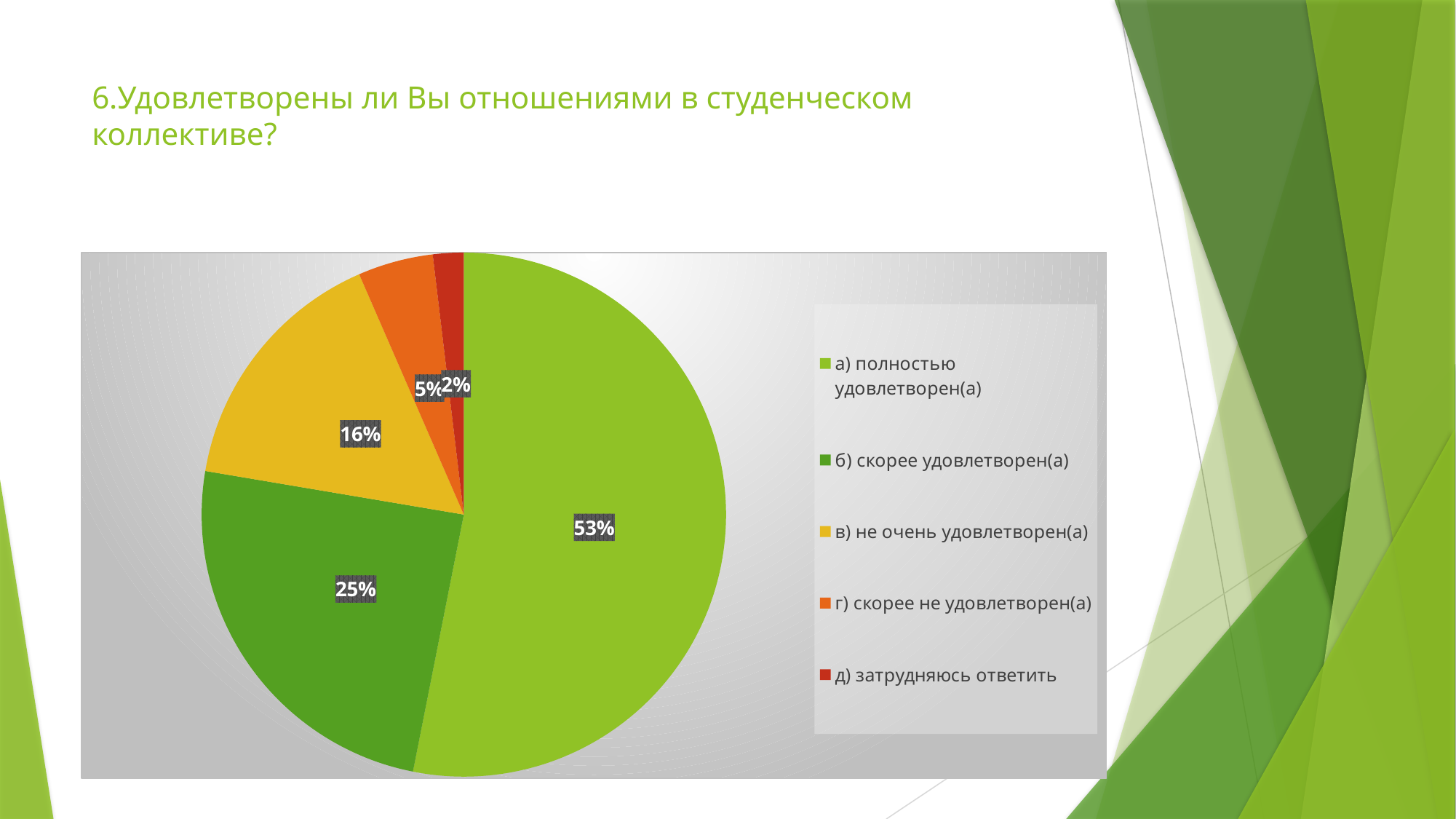
What is the value for "б) скорее удовлетворен(а)"? 25% What is the value for "г) скорее не удовлетворен(а)"? 5% What colour is the slice for "в) не очень удовлетворен(а)"? yellow How many categories does the pie chart have? 5 Which category has the smallest slice of the pie? д) затрудняюсь ответить Which category has the largest slice of the pie? а) полностью удовлетворен(а) Which is larger: the value for "в) не очень удовлетворен(а)" or the value for "г) скорее не удовлетворен(а)"? в) не очень удовлетворен(а) What kind of chart is shown on the slide? pie chart What is the value for "д) затрудняюсь ответить"? 2% What share of the pie does "а) полностью удовлетворен(а)" take? 53% What is the value for "в) не очень удовлетворен(а)"? 16% What is the difference between the values for "а) полностью удовлетворен(а)" and "б) скорее удовлетворен(а)"? 28%